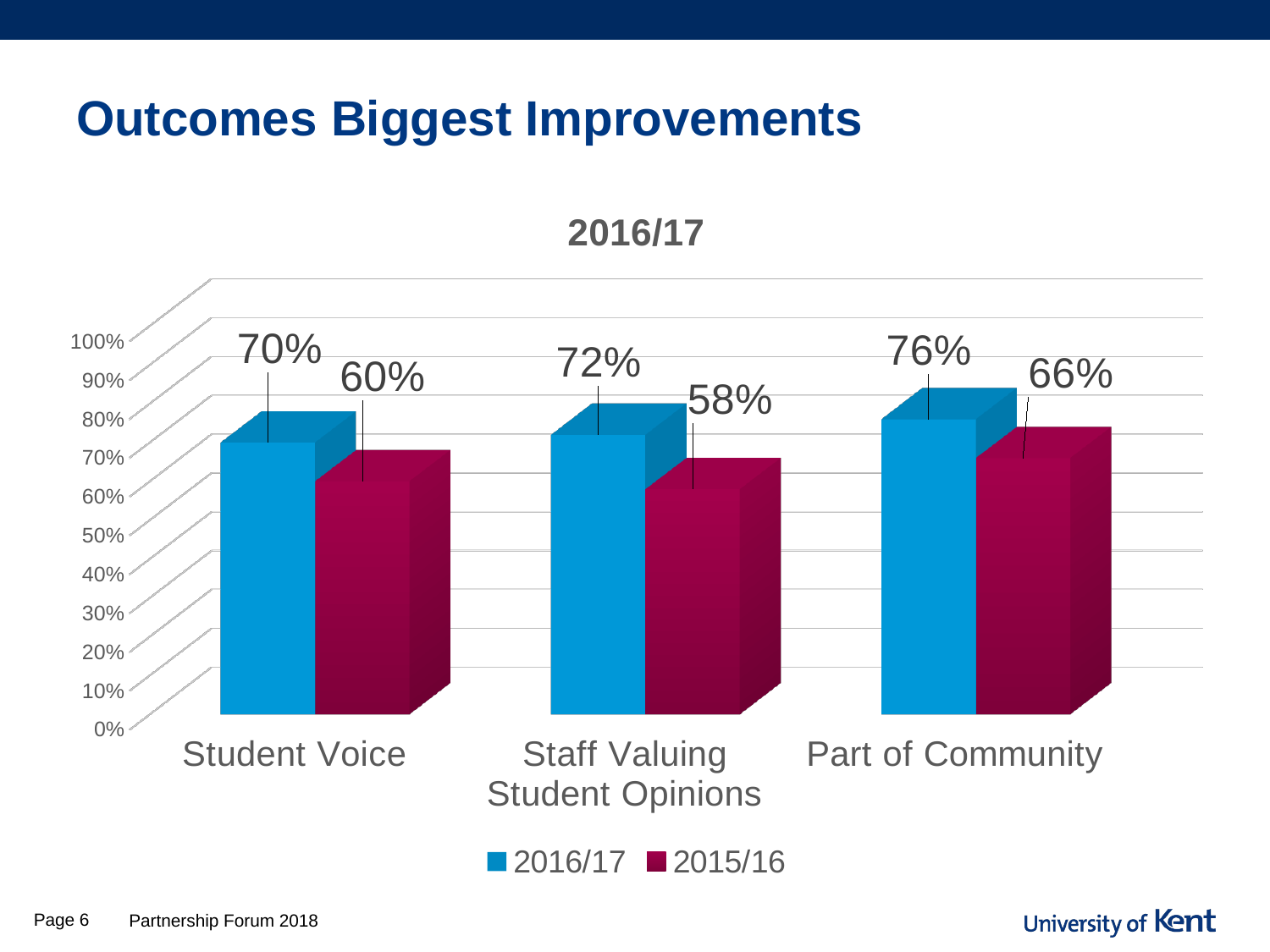
Which category has the highest 2016/17 value? Part of Community What is the difference between the 2016/17 and 2015/16 values for Staff Valuing Student Opinions? 14% What is the 2016/17 value for Part of Community? 76% What is the 2015/16 value for Staff Valuing Student Opinions? 58% What is the title of the chart? 2016/17 What is the 2015/16 value for Part of Community? 66% How many categories are shown on the x axis? 3 What kind of chart is shown on the slide? Bar chart What is the 2016/17 value for Student Voice? 70% Which category has the lowest 2015/16 value? Staff Valuing Student Opinions Which is larger for Student Voice: the 2016/17 value or the 2015/16 value? 2016/17 How many series does the legend list? 2